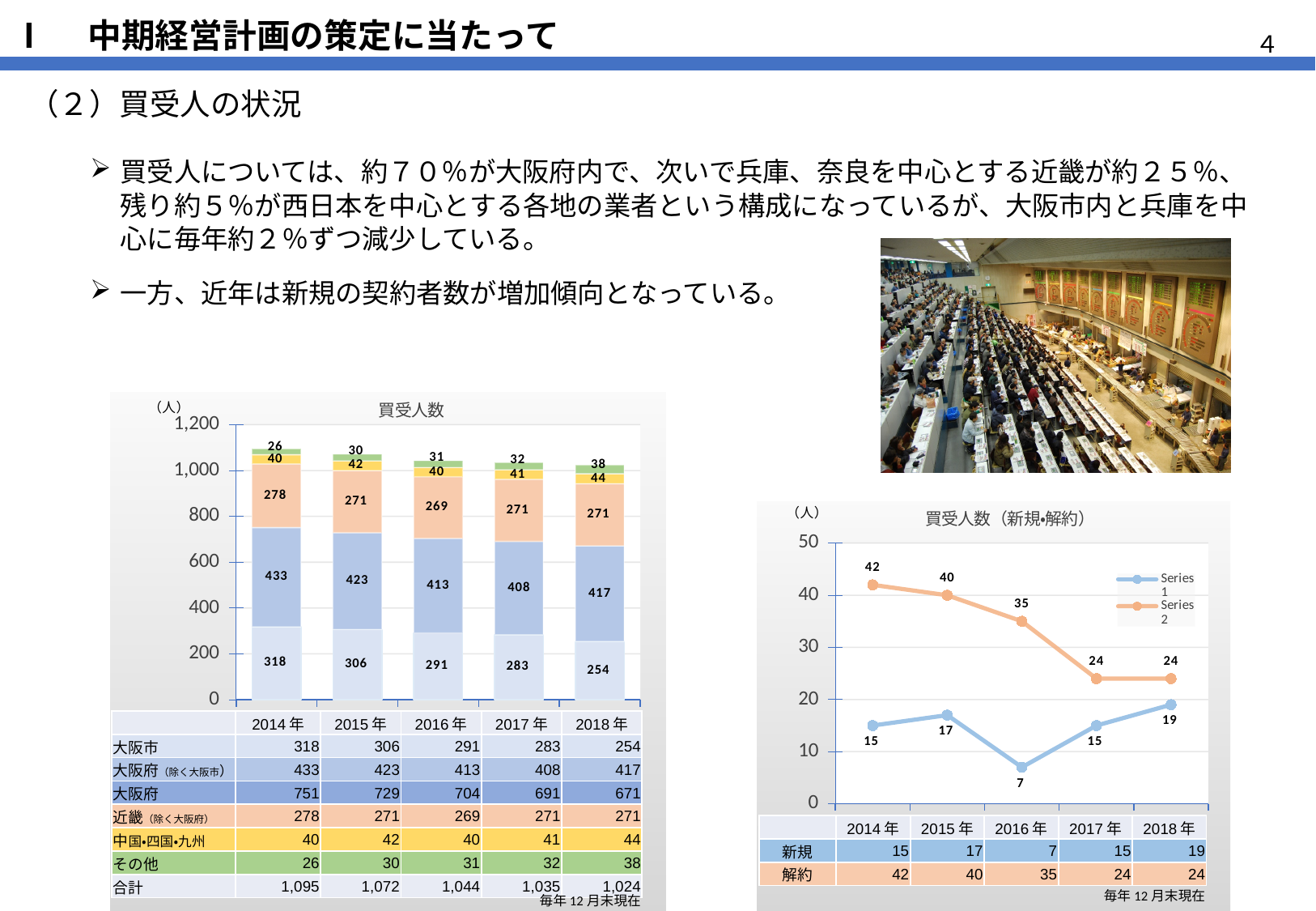
How many years are shown on the x axis of the 買受人数 bar chart? 5 In the 買受人数（新規•解約） line chart, which year has the lowest 新規 value? 2016年 In the 買受人数 bar chart, do the 大阪市 values rise or fall from 2014年 to 2018年? fall In the 買受人数 bar chart, what is the difference between the 大阪市 values for 2014年 and 2018年? 64 How many series does the legend of the 買受人数（新規•解約） chart list? 2 In the 買受人数（新規•解約） line chart, what is the difference between 解約 and 新規 in 2018年? 5 In the 買受人数（新規•解約） line chart, what is the 新規 value for 2016年? 7 In the 買受人数 bar chart, what is the value for 大阪市 in 2018年? 254 In the 買受人数（新規•解約） line chart, which year has the highest 解約 value? 2014年 What kind of chart is the 買受人数 chart on the left? stacked bar chart In the 買受人数 bar chart, what is the value for 近畿（除く大阪府） in 2014年? 278 In the 買受人数 bar chart, what is the total of the stacked bar for 2016年? 1,044